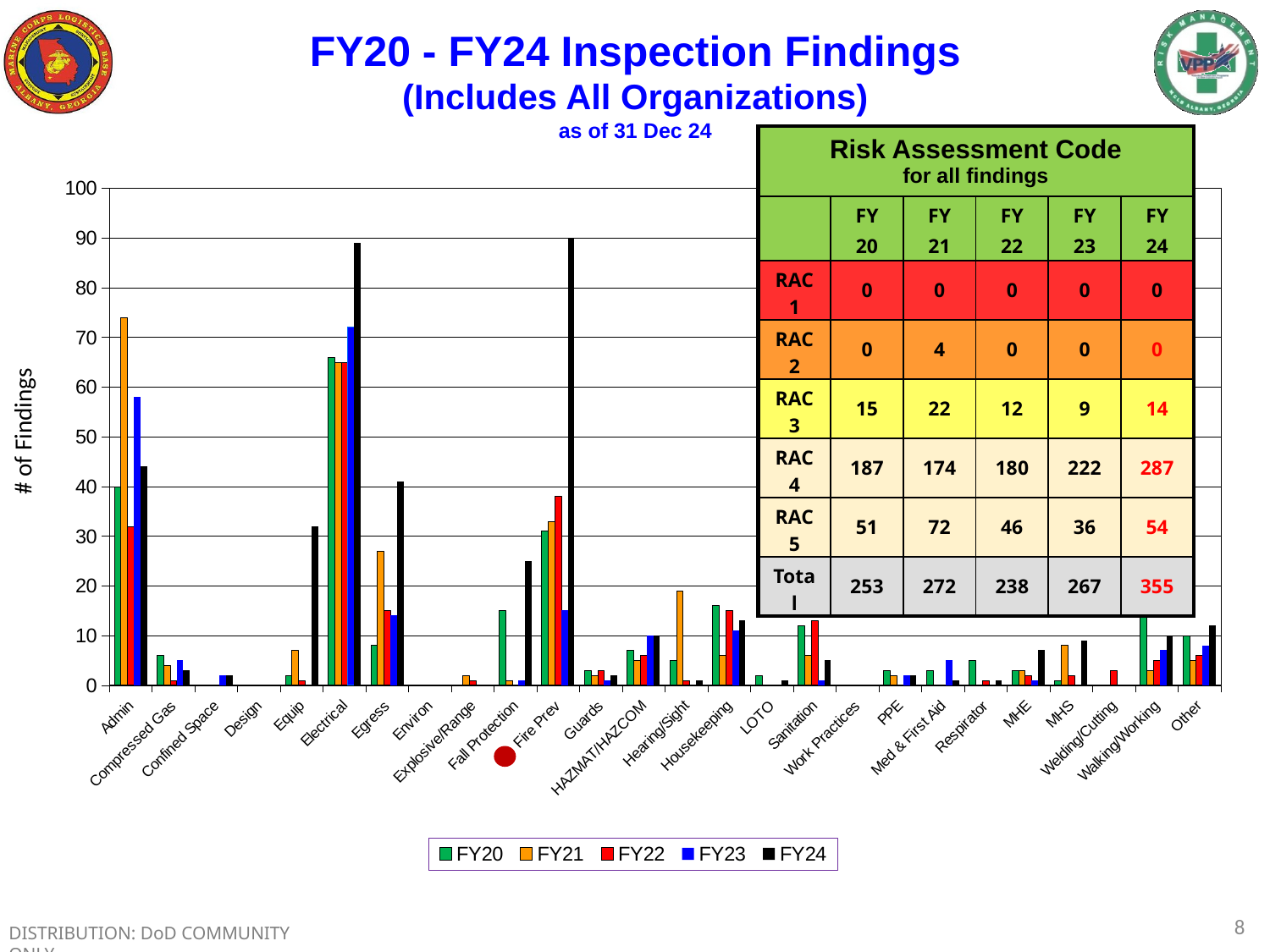
Which category has the tallest FY21 bar? Admin What kind of chart is shown on the slide? bar chart Which colour represents the FY24 series in the chart? black Is the FY24 value for Electrical greater or less than 80? greater Is the FY21 value for Admin greater or less than 70? greater What is the label on the vertical axis of the chart? # of Findings Is the FY24 value for Fire Prev greater or less than 80? greater How many series does the chart legend list? 5 For Electrical, which is larger: the FY20 value or the FY24 value? FY24 How many categories are shown along the x axis of the chart? 26